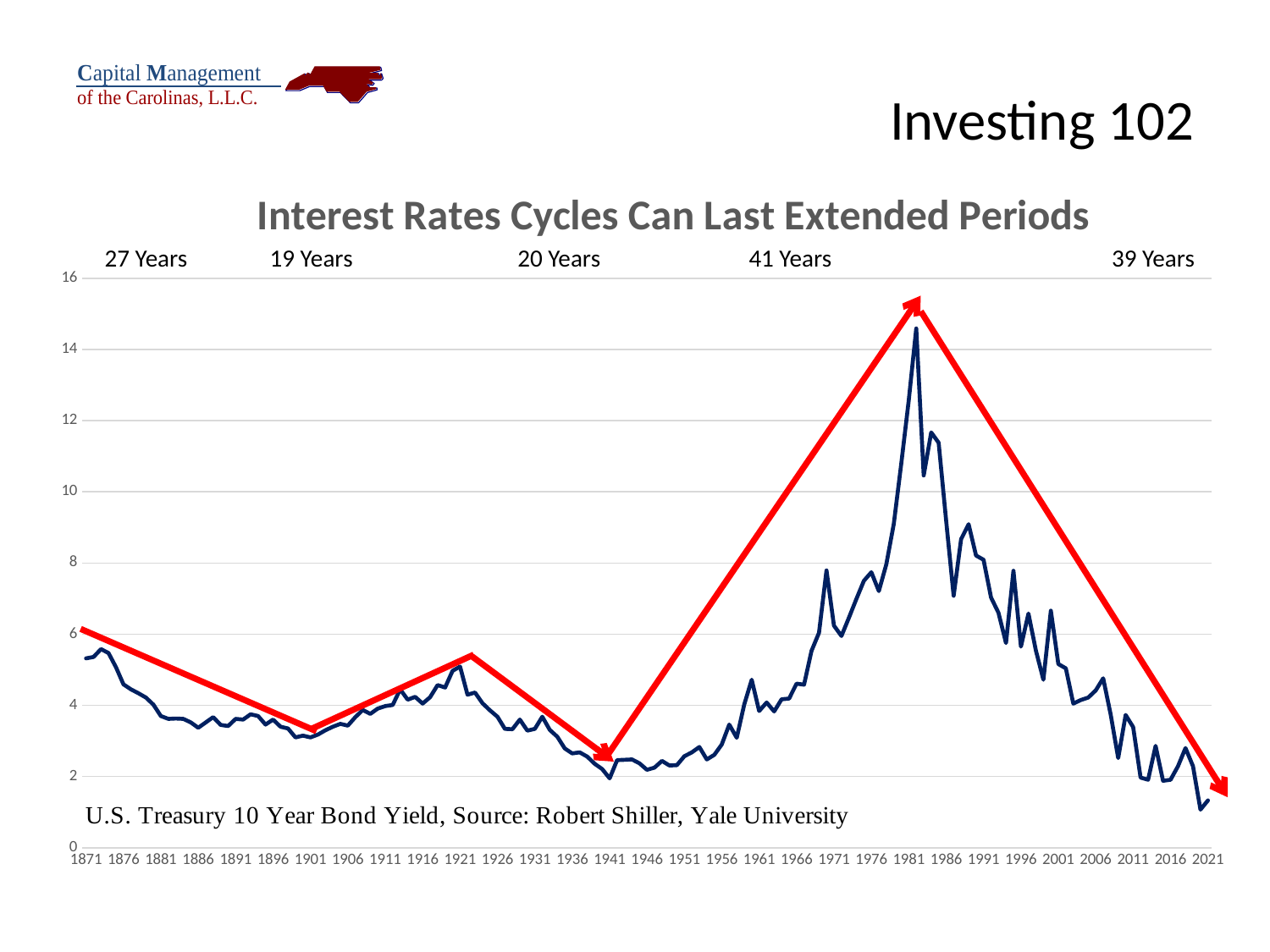
What data series does the chart plot, according to the note on the chart? U.S. Treasury 10 Year Bond Yield Does the bond yield generally rise or fall between 1981 and 2021? fall Is the peak value of the bond yield around 1981 greater or less than 12? greater Does the bond yield generally rise or fall between 1941 and 1981? rise Is the value of the bond yield at 2021 greater or less than 4? less What kind of chart is shown on the slide? line chart How many cycle-length labels (e.g. '27 Years') are shown above the chart? 5 Which of the labeled interest rate cycles is the shortest? 19 Years What is the title of the chart? Interest Rates Cycles Can Last Extended Periods Which of the labeled interest rate cycles is the longest? 41 Years Is the value of the bond yield around 1941 greater or less than 4? less